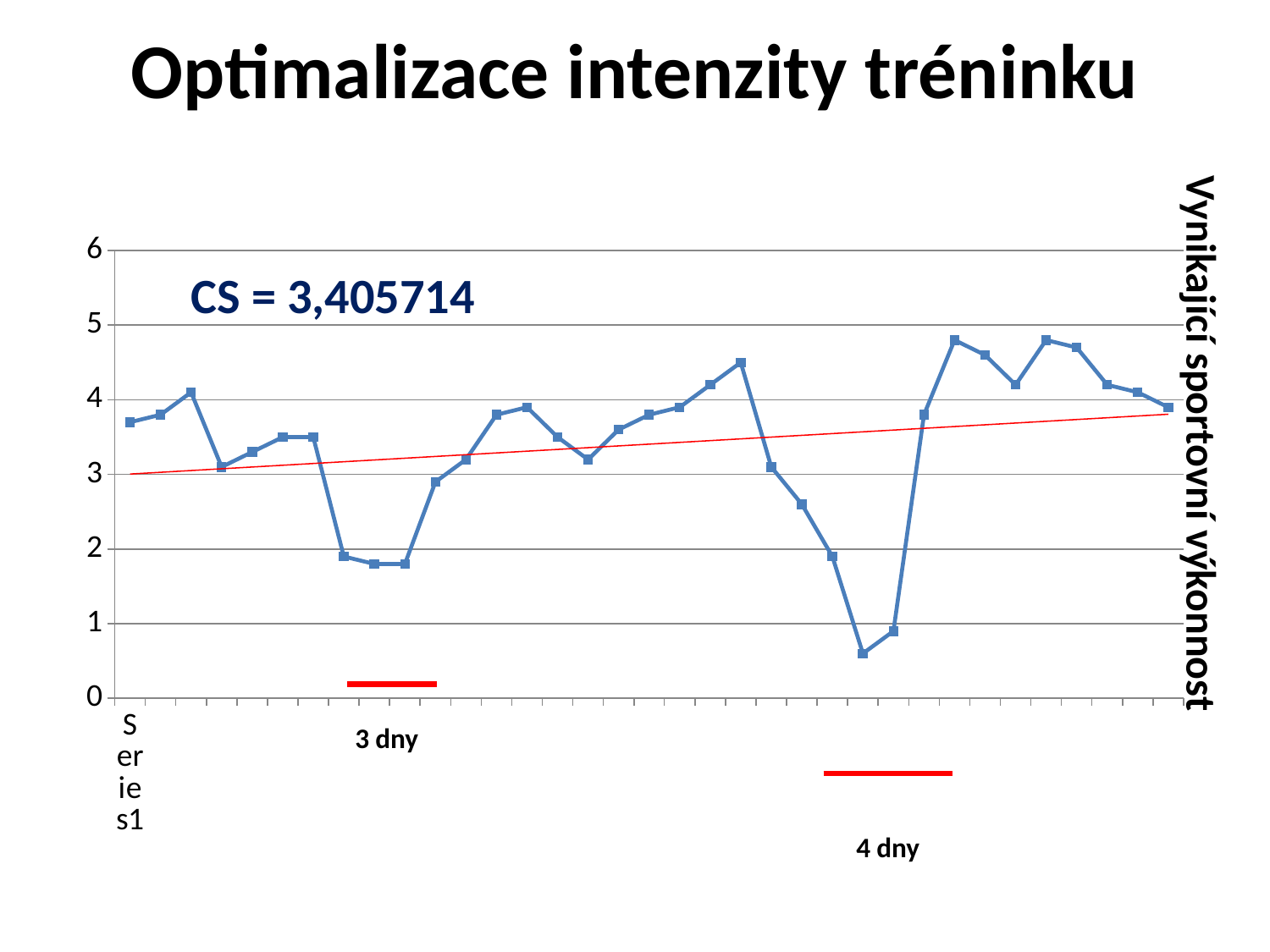
Does the red trend line rise or fall from left to right? rises Is the lowest point of the blue line greater or less than 1? less What is the title of the vertical axis? Vynikající sportovní výkonnost What is the CS value printed on the chart? CS = 3,405714 What kind of chart is shown on the slide? line chart What is the highest value shown on the vertical axis? 6 Is the highest point of the blue line greater or less than 4? greater